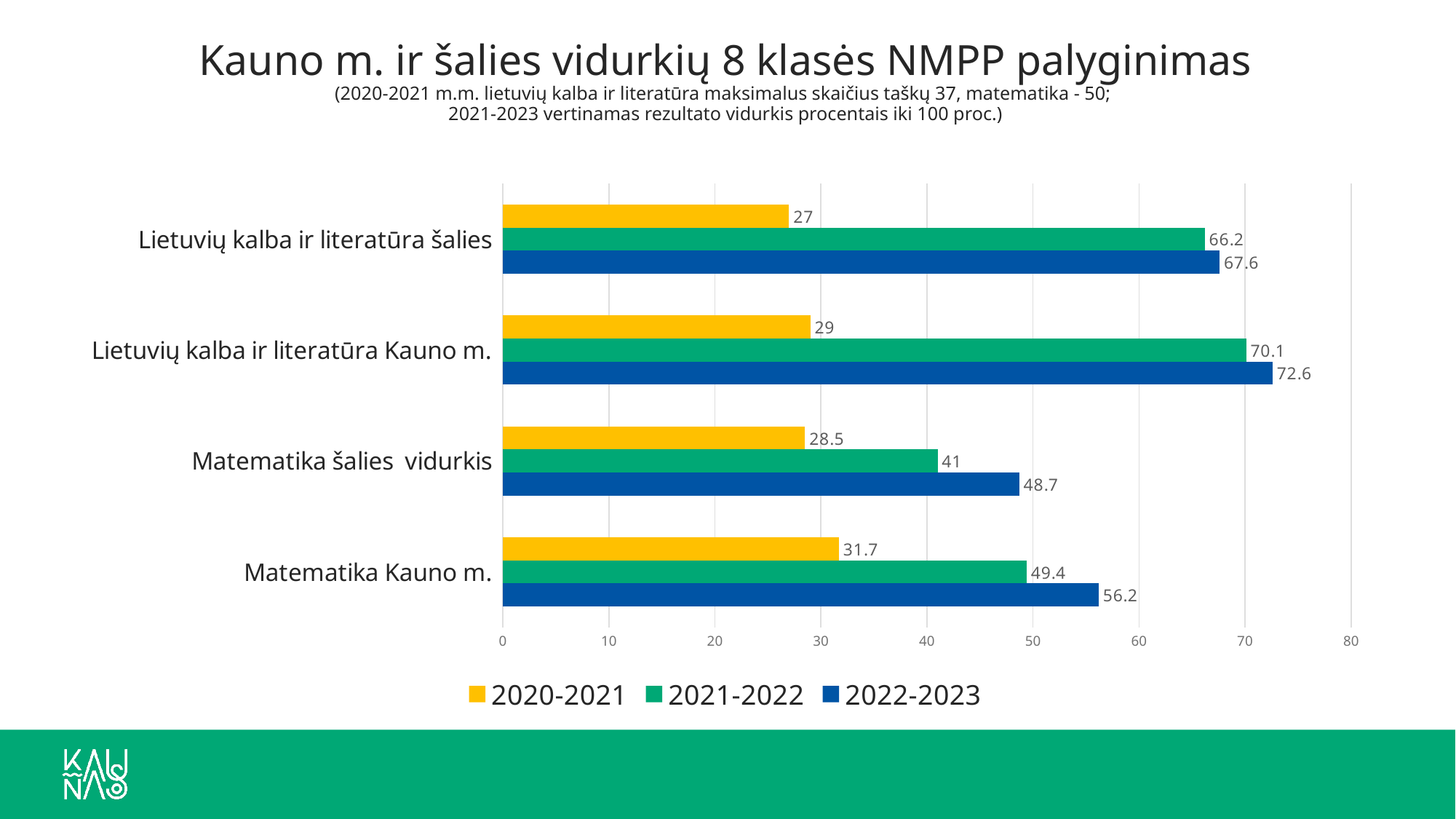
How many categories are shown on the chart? 4 Which series is shown in yellow in the legend? 2020-2021 Which category has the lowest 2020-2021 value? Lietuvių kalba ir literatūra šalies What is the difference between the 2021-2022 and 2020-2021 values for Matematika šalies vidurkis? 12.5 Which category has the highest 2022-2023 value? Lietuvių kalba ir literatūra Kauno m. What is the 2022-2023 value for Lietuvių kalba ir literatūra Kauno m.? 72.6 What is the 2020-2021 value for Matematika šalies vidurkis? 28.5 What kind of chart is shown on the slide? Bar chart What is the 2021-2022 value for Matematika Kauno m.? 49.4 Which is larger: the 2021-2022 value for Lietuvių kalba ir literatūra šalies or for Lietuvių kalba ir literatūra Kauno m.? Lietuvių kalba ir literatūra Kauno m. What is the difference between the 2022-2023 values for Matematika Kauno m. and Matematika šalies vidurkis? 7.5 How many series does the legend list? 3